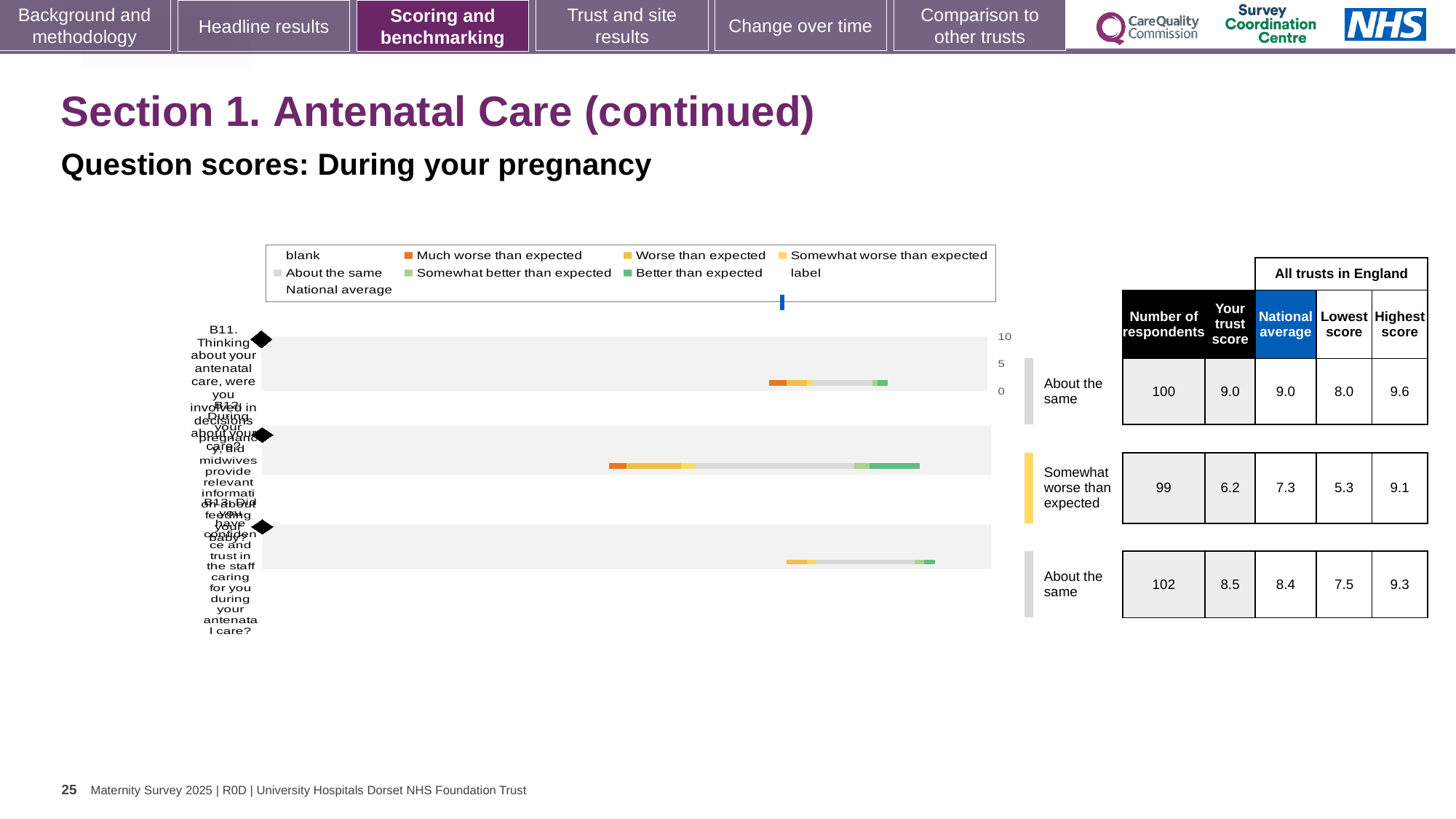
How many respondents answered question B13? 102 What is the trust score for question B12 (midwives provide relevant information about feeding your baby)? 6.2 What benchmark category is shown for question B12? Somewhat worse than expected How many questions (bars) are plotted in the chart? 3 What is the trust score for question B11 (involved in decisions about antenatal care)? 9.0 Which question has the lowest trust score? B12 What kind of chart is shown on the slide? bar chart What is the national average for question B13 (confidence and trust in staff during antenatal care)? 8.4 Which question has the highest number of respondents? B13 What is the difference between the trust scores for B11 and B12? 2.8 Is the trust score for B13 larger than the national average for B13? Yes, 8.5 vs 8.4 What is the highest score among all trusts in England for question B11? 9.6